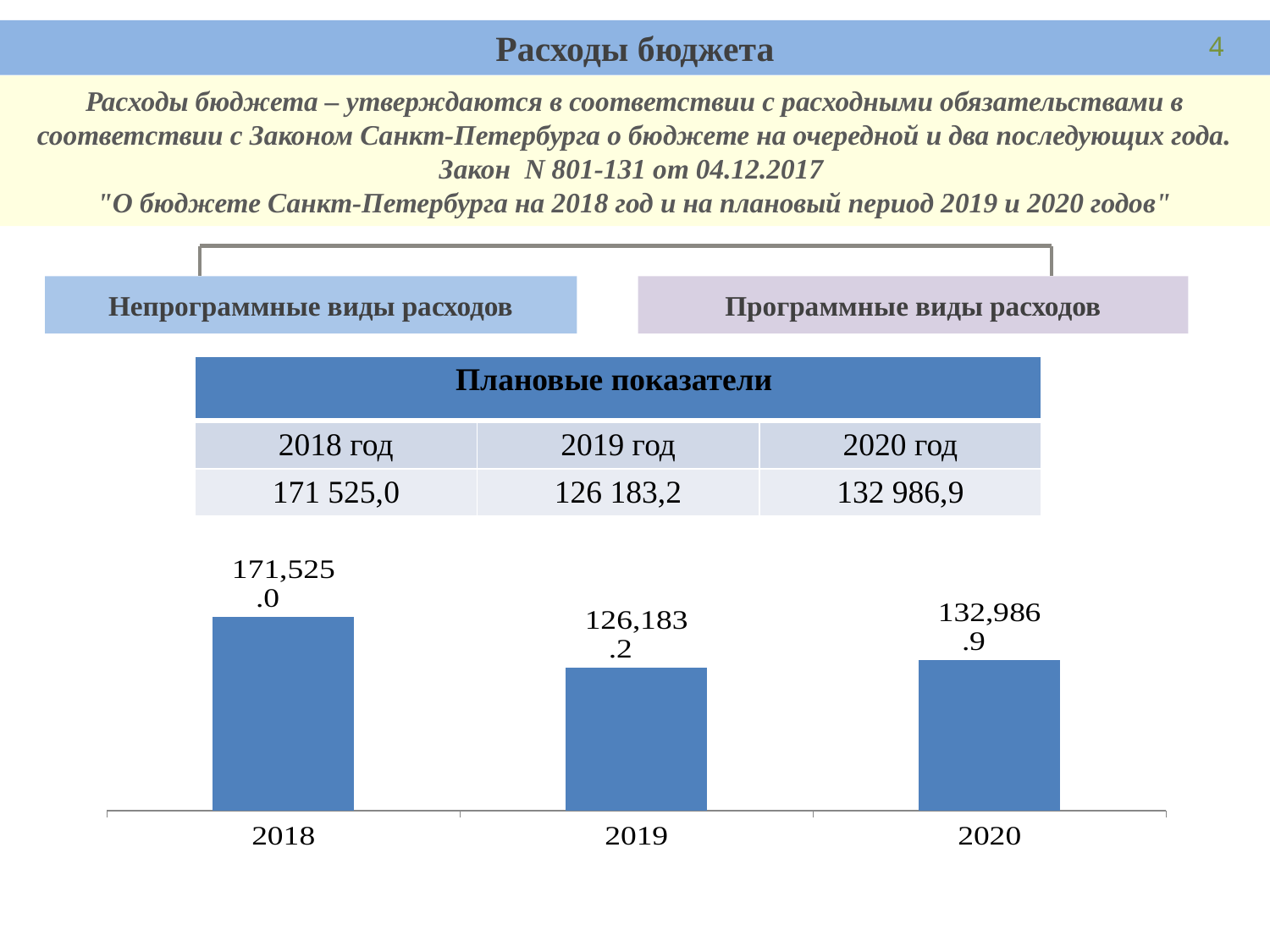
Which year has the highest bar in the chart? 2018 What value is shown for 2018 in the bar chart? 171,525.0 Does the value rise or fall from 2018 to 2019 in the bar chart? fall What is the difference between the values for 2020 and 2019 in the bar chart? 6,803.7 What kind of chart is shown on the slide? bar chart Which year has the lowest bar in the chart? 2019 What colour are the bars in the chart? blue Which is larger in the bar chart, the value for 2019 or the value for 2020? 2020 What value is shown for 2019 in the bar chart? 126,183.2 What value is shown for 2020 in the bar chart? 132,986.9 What is the difference between the values for 2018 and 2019 in the bar chart? 45,341.8 How many bars are plotted in the chart? 3